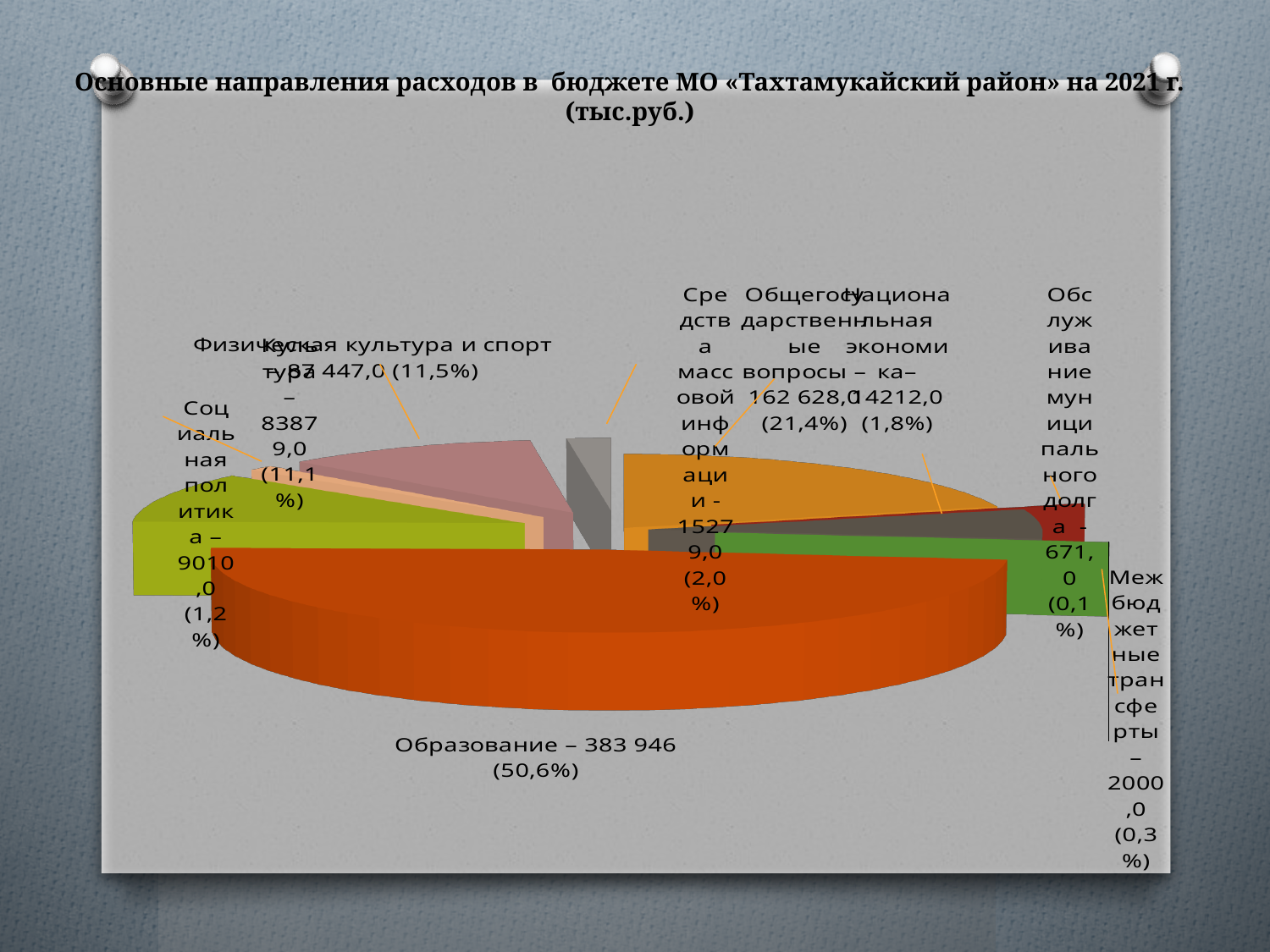
What share of the pie does Образование take? 50,6% Which is larger, Общегосударственные вопросы or Физическая культура и спорт? Общегосударственные вопросы What value is shown for Межбюджетные трансферты? 2000,0 What value is shown for Образование? 383 946 Which category has the smallest slice of the pie? Обслуживание муниципального долга What is the difference in percentage points between the shares of Образование and Общегосударственные вопросы? 29,2% What value is shown for Общегосударственные вопросы? 162 628,0 What kind of chart is shown on the slide? pie chart How many categories are shown in the pie chart? 9 What share of the pie does Социальная политика take? 1,2% Which category has the largest slice of the pie? Образование What share of the pie does Общегосударственные вопросы take? 21,4%